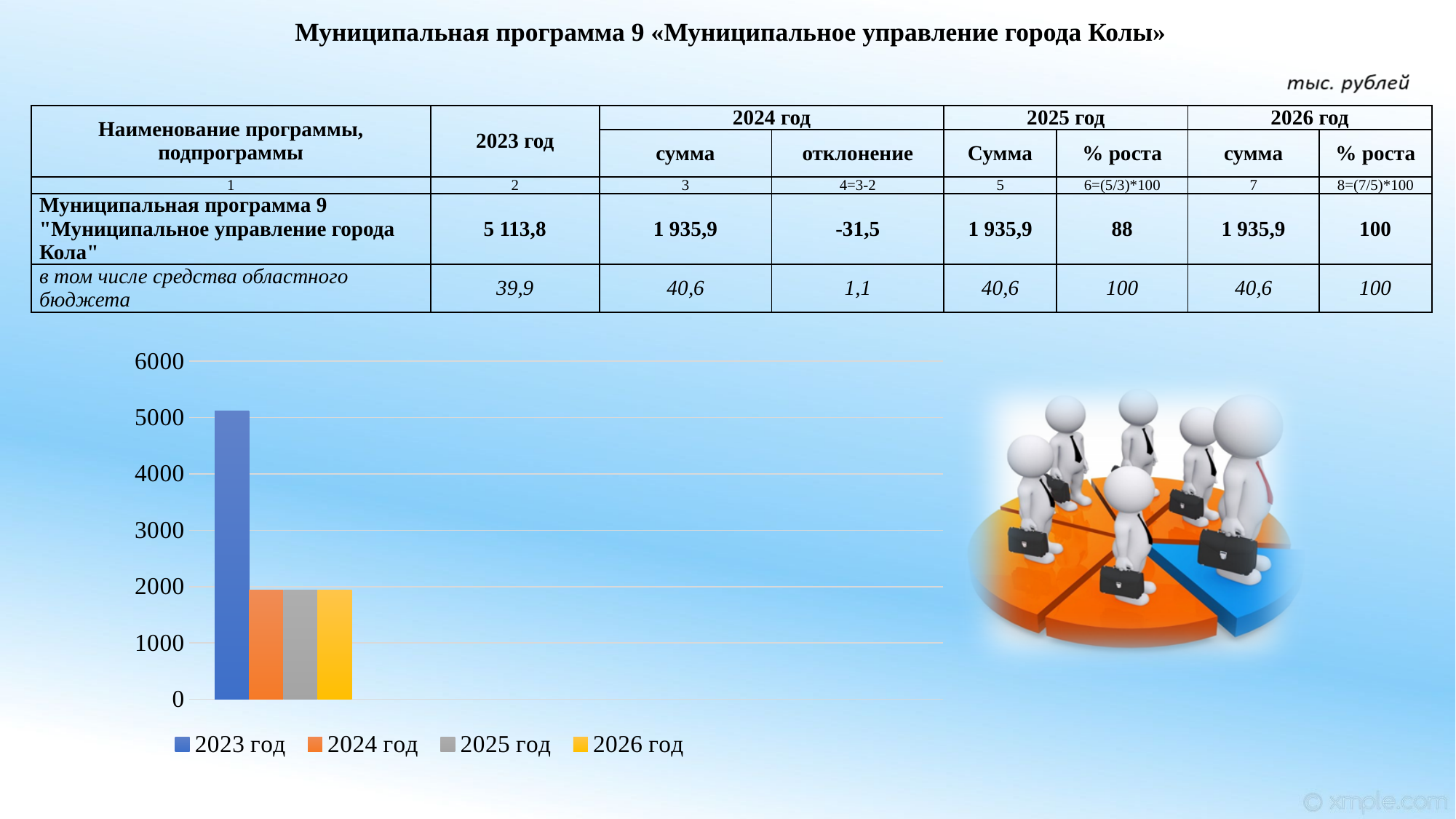
Which is larger in the chart, the bar for 2023 год or the bar for 2024 год? 2023 год Is the value for 2024 год in the chart greater or less than 3000? less How many series does the chart legend list? 4 What kind of chart is shown on the slide? bar chart Which series has the highest bar in the chart? 2023 год What colour is the bar for 2024 год in the chart? orange According to the table, what is the sum for 2025 год plotted in the chart? 1 935,9 Is the value for 2023 год in the chart greater or less than 4000? greater What is the highest value shown on the chart's vertical axis? 6000 According to the table, what is the value for 2023 год plotted in the chart? 5 113,8 Is the value for 2026 год in the chart greater or less than 1000? greater Using the table values, what is the difference between the 2023 год bar and the 2024 год bar? 3 177,9